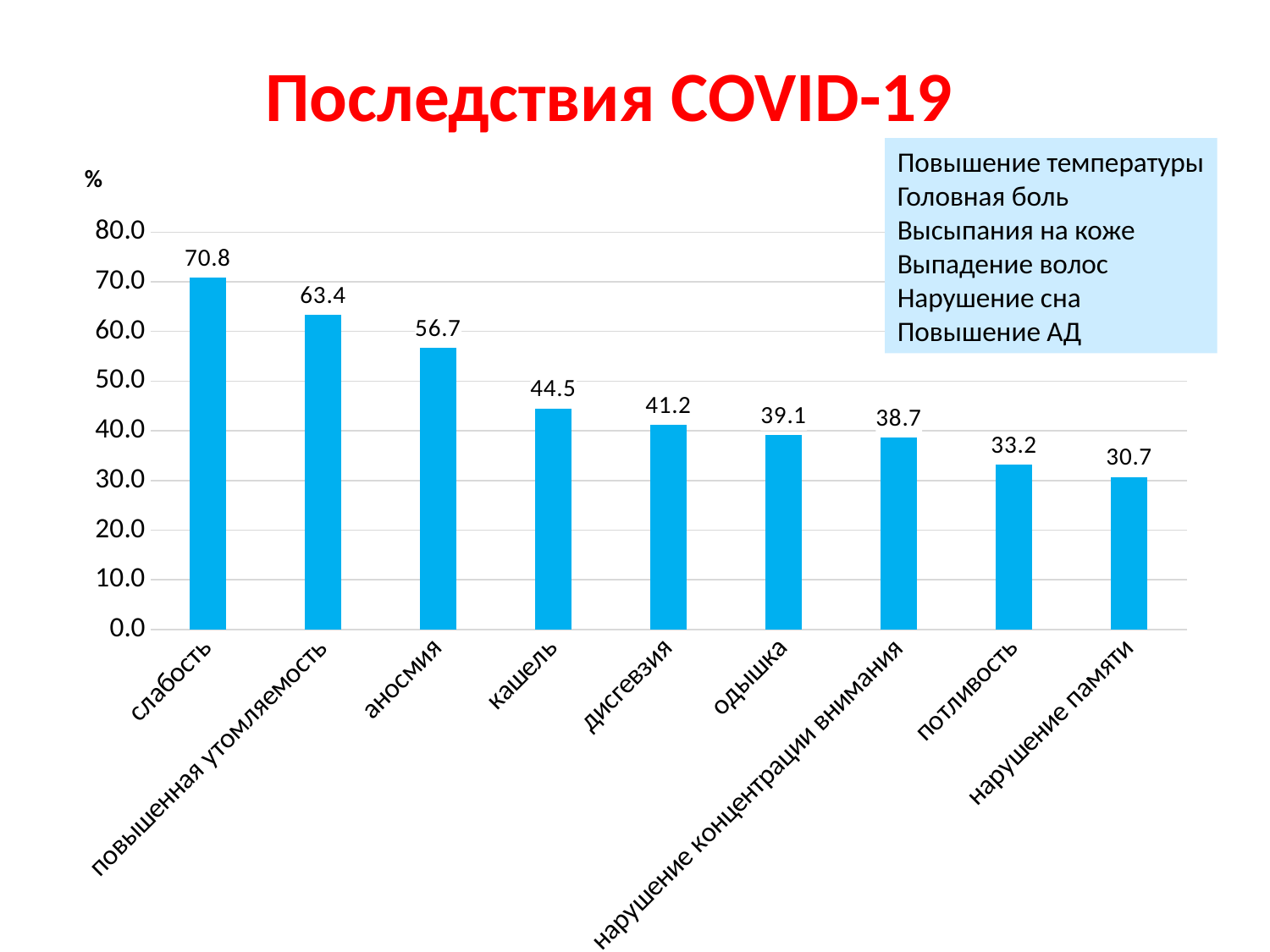
What is the value for нарушение концентрации внимания? 38.7 What is the value for аносмия? 56.7 Is the value for аносмия greater or less than 50.0? greater What is the title of the slide? Последствия COVID-19 Which is larger, the value for дисгевзия or the value for одышка? дисгевзия What is the value for слабость? 70.8 How many categories are shown in the chart? 9 What is the difference between the values for слабость and повышенная утомляемость? 7.4 What kind of chart is shown on the slide? bar chart Which category has the highest value? слабость What is the difference between the values for кашель and потливость? 11.3 Which category has the lowest value? нарушение памяти